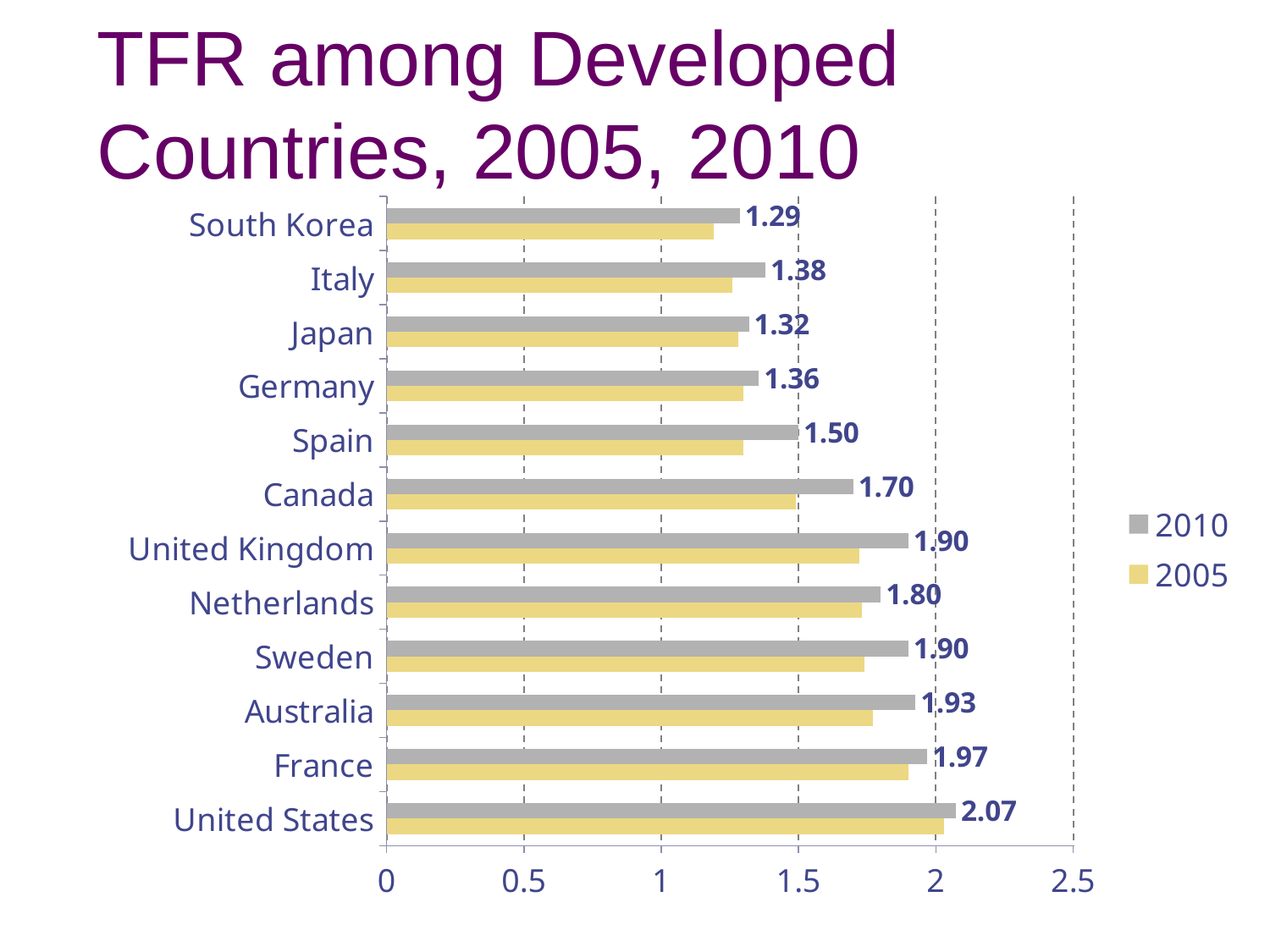
Which colour represents the 2005 series in the legend? yellow Which has the larger 2010 TFR value, France or Australia? France What kind of chart is shown on the slide? bar chart Which country has the lowest 2010 TFR value? South Korea Is the 2005 value for the United Kingdom greater or less than 1.5? greater What is the difference between the 2010 TFR values for the United States and South Korea? 0.78 Which country has the highest 2010 TFR value? United States Is the 2005 value for Spain greater or less than 1.5? less What is the 2010 TFR value for Spain? 1.50 How many series does the legend list? 2 How many countries are shown on the chart? 12 What is the 2010 TFR value for the United States? 2.07